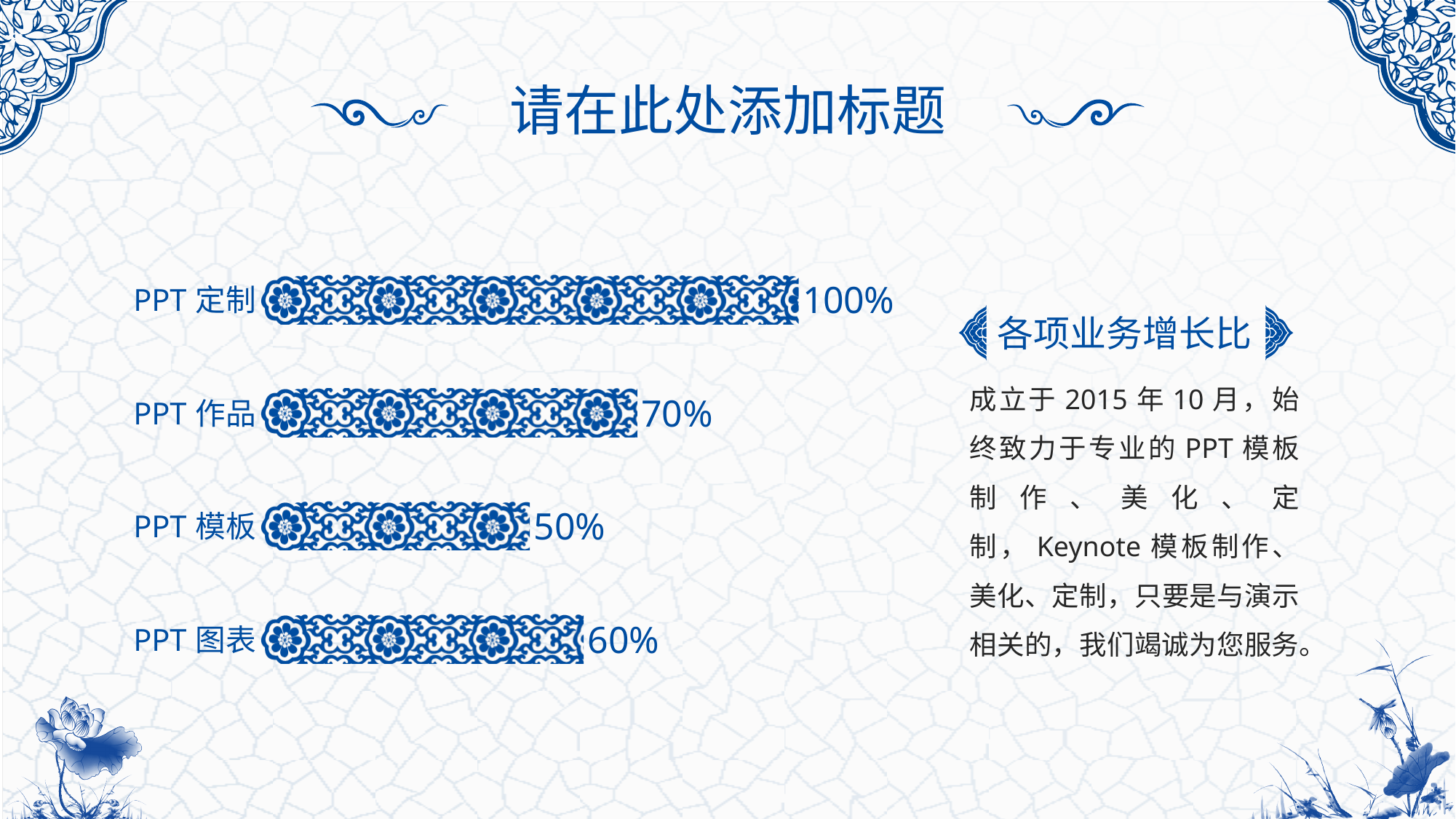
What kind of chart is shown on the slide? Bar chart What is the difference between the values for PPT 图表 and PPT 模板? 10% What is the value for PPT 模板? 50% Which category has the highest value? PPT 定制 How many categories are shown in the chart? 4 What is the value for PPT 图表? 60% Which category has the lowest value? PPT 模板 What is the value for PPT 作品? 70% Which is larger, the value for PPT 作品 or the value for PPT 图表? PPT 作品 What is the value for PPT 定制? 100% What is the difference between the values for PPT 定制 and PPT 作品? 30% What is the heading next to the chart describing what it shows? 各项业务增长比